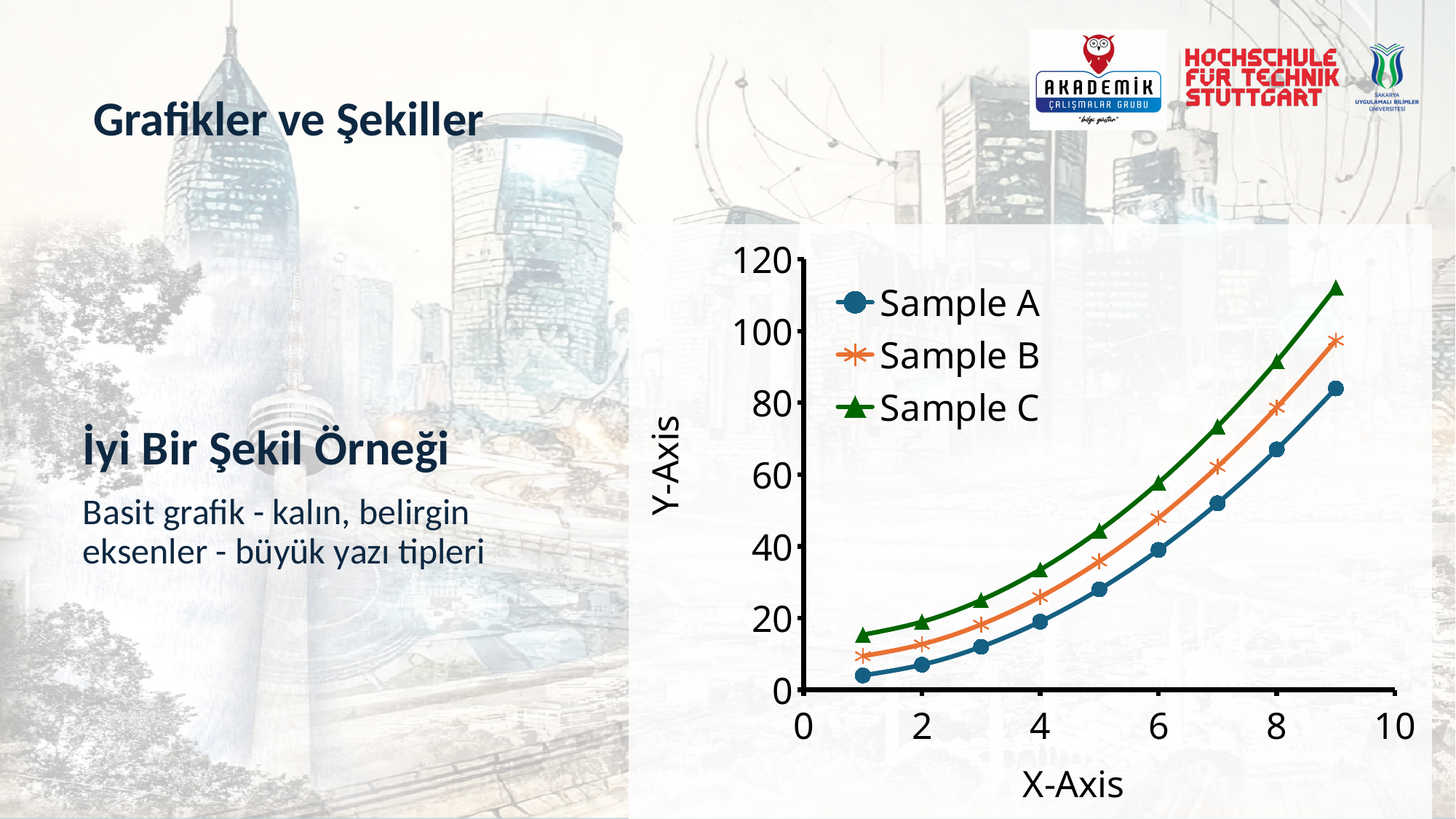
Is the value for Sample C at x = 9 greater or less than 100? greater Which series is drawn with triangle markers? Sample C At x = 9, which is larger: the value for Sample C or the value for Sample A? Sample C Which series has the highest value at x = 9? Sample C Is the value for Sample A at x = 9 greater or less than 100? less How many data points does the Sample A series have? 9 Do the values of Sample C rise or fall as the x axis increases? rise Is the value for Sample A at x = 1 greater or less than 20? less What is the title of the vertical axis? Y-Axis How many series does the legend list? 3 What kind of chart is shown on the slide? line chart Which series has the lowest value at x = 9? Sample A